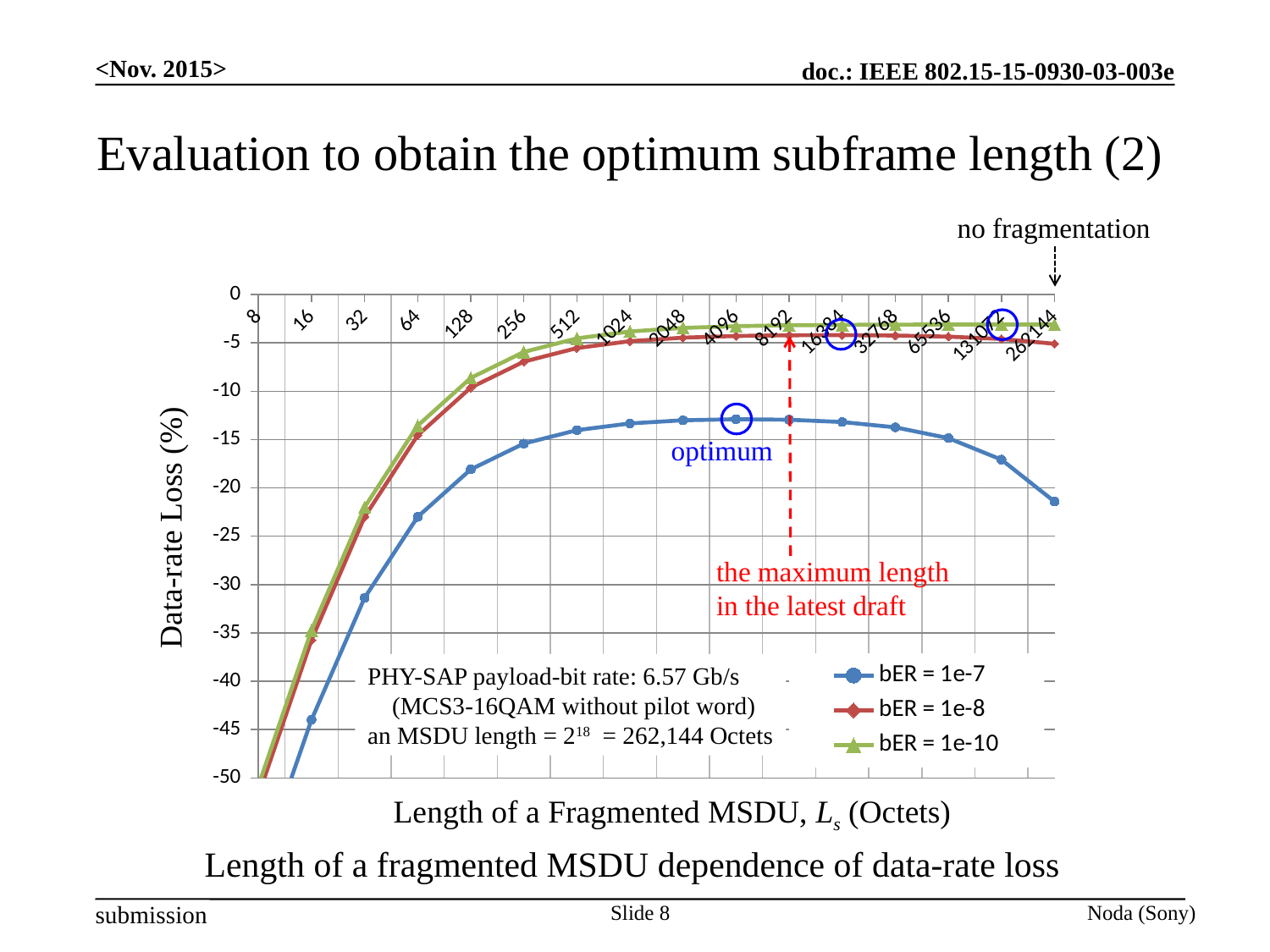
At a length of 8192 octets, which series has the larger value, bER = 1e-7 or bER = 1e-8? bER = 1e-8 How many x-axis categories (MSDU lengths) are plotted on the chart? 16 Which series has the lowest value at a length of 32 octets? bER = 1e-7 What kind of chart is shown on the slide? line chart Is the value for bER = 1e-10 at a length of 256 octets greater or less than -10? greater What is the title of the vertical axis? Data-rate Loss (%) At a length of 262144 octets, which series has the higher data-rate loss value, bER = 1e-7 or bER = 1e-10? bER = 1e-10 Is the value for bER = 1e-8 at a length of 64 octets greater or less than -10? less Is the value for bER = 1e-7 at a length of 262144 octets greater or less than -15? less How many series does the legend list? 3 Does the bER = 1e-7 series rise or fall as the length increases from 8192 to 262144 octets? fall